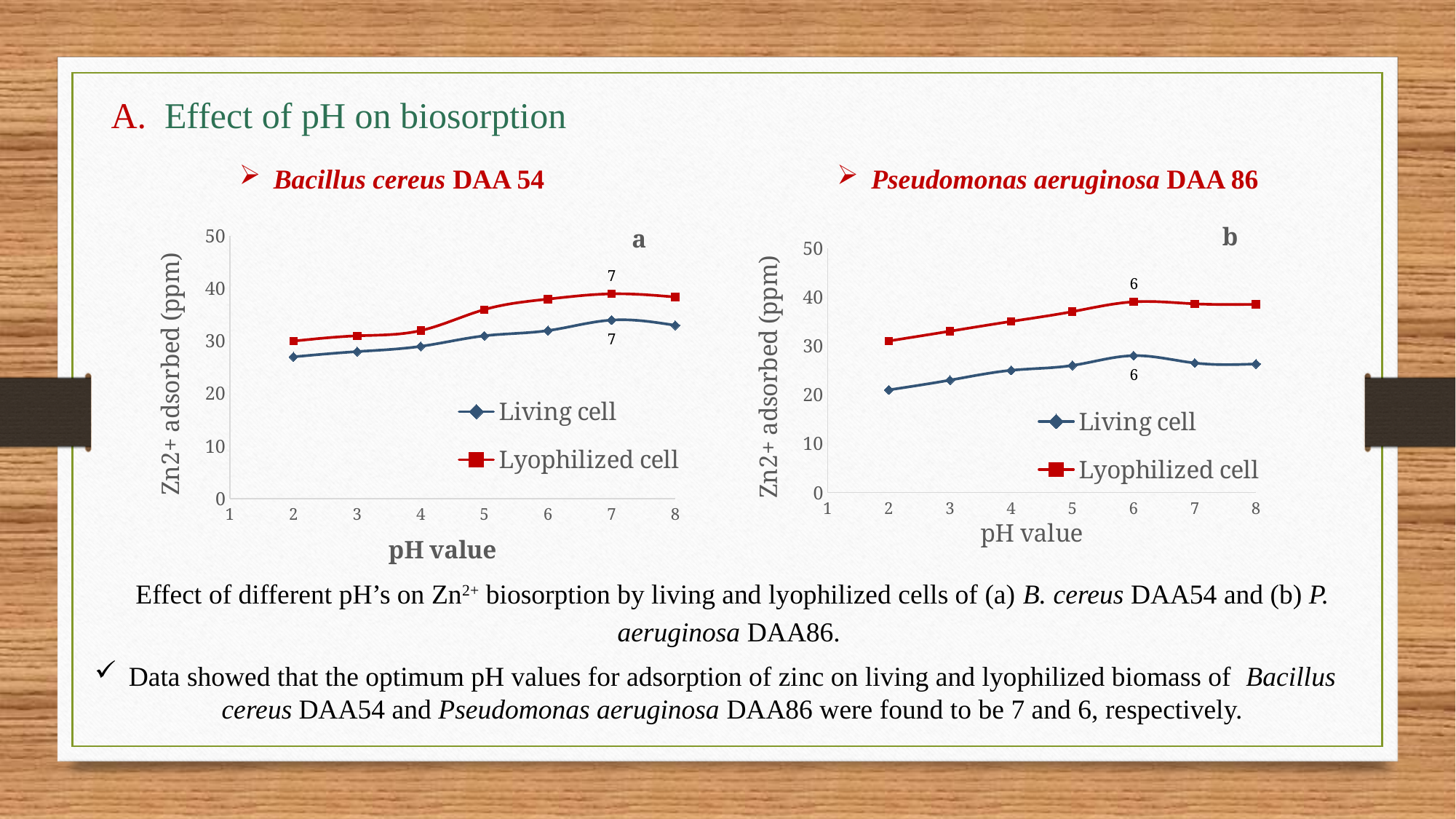
How many series does the legend list in the Pseudomonas aeruginosa DAA 86 chart (chart b)? 2 In the Bacillus cereus DAA 54 chart (chart a), at which pH value does the Living cell series reach its highest point? 7 In the Pseudomonas aeruginosa DAA 86 chart (chart b), does the Lyophilized cell series rise or fall from pH 2 to pH 6? rise In the Bacillus cereus DAA 54 chart (chart a), which series has the higher value at pH 5, Living cell or Lyophilized cell? Lyophilized cell In the Bacillus cereus DAA 54 chart (chart a), is the Living cell value at pH 2 greater or less than 30? less What type of chart is used for Bacillus cereus DAA 54 (chart a)? Line chart What is the y-axis title of the Bacillus cereus DAA 54 chart (chart a)? Zn2+ adsorbed (ppm) In the Pseudomonas aeruginosa DAA 86 chart (chart b), is the Lyophilized cell value at pH 6 greater or less than 30? greater In the Pseudomonas aeruginosa DAA 86 chart (chart b), is the Living cell value at pH 6 greater or less than 30? less In the Bacillus cereus DAA 54 chart (chart a), how many pH values have plotted points for the Living cell series? 7 In the Pseudomonas aeruginosa DAA 86 chart (chart b), at which pH value does the Lyophilized cell series reach its highest point? 6